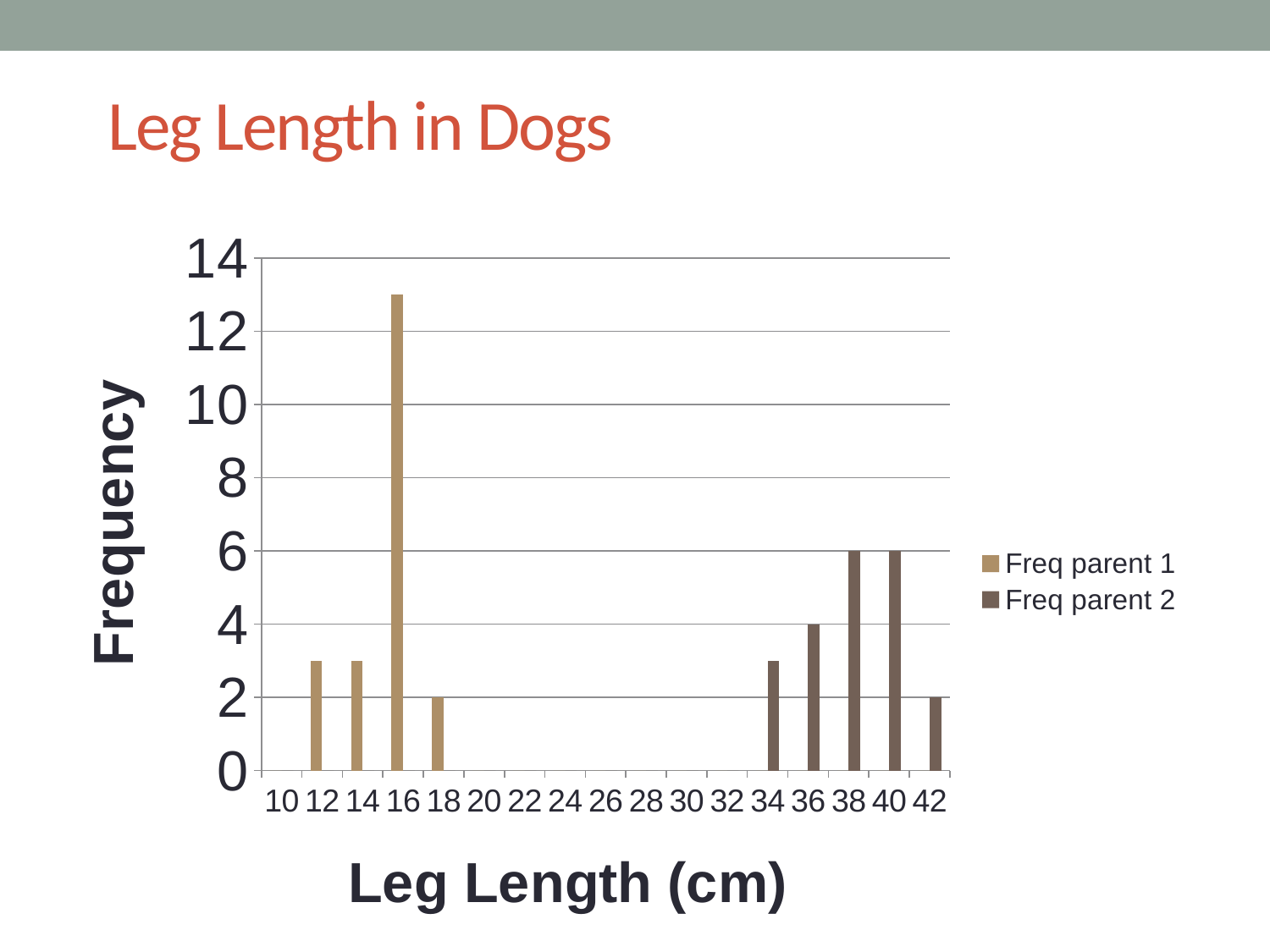
How many series does the legend list? 2 What is the frequency for a leg length of 42 cm? 2 What is the difference between the frequency at 38 cm and the frequency at 42 cm? 4 What is the frequency for a leg length of 18 cm? 2 What is the frequency for a leg length of 36 cm? 4 What is the title of the x axis? Leg Length (cm) Is the frequency for a leg length of 16 cm greater or less than 12? greater What is the frequency for a leg length of 38 cm? 6 Which leg length has the highest frequency? 16 cm What kind of chart is shown on the slide? bar chart What are the two series named in the legend? Freq parent 1 and Freq parent 2 Which has the higher frequency, a leg length of 16 cm or 40 cm? 16 cm